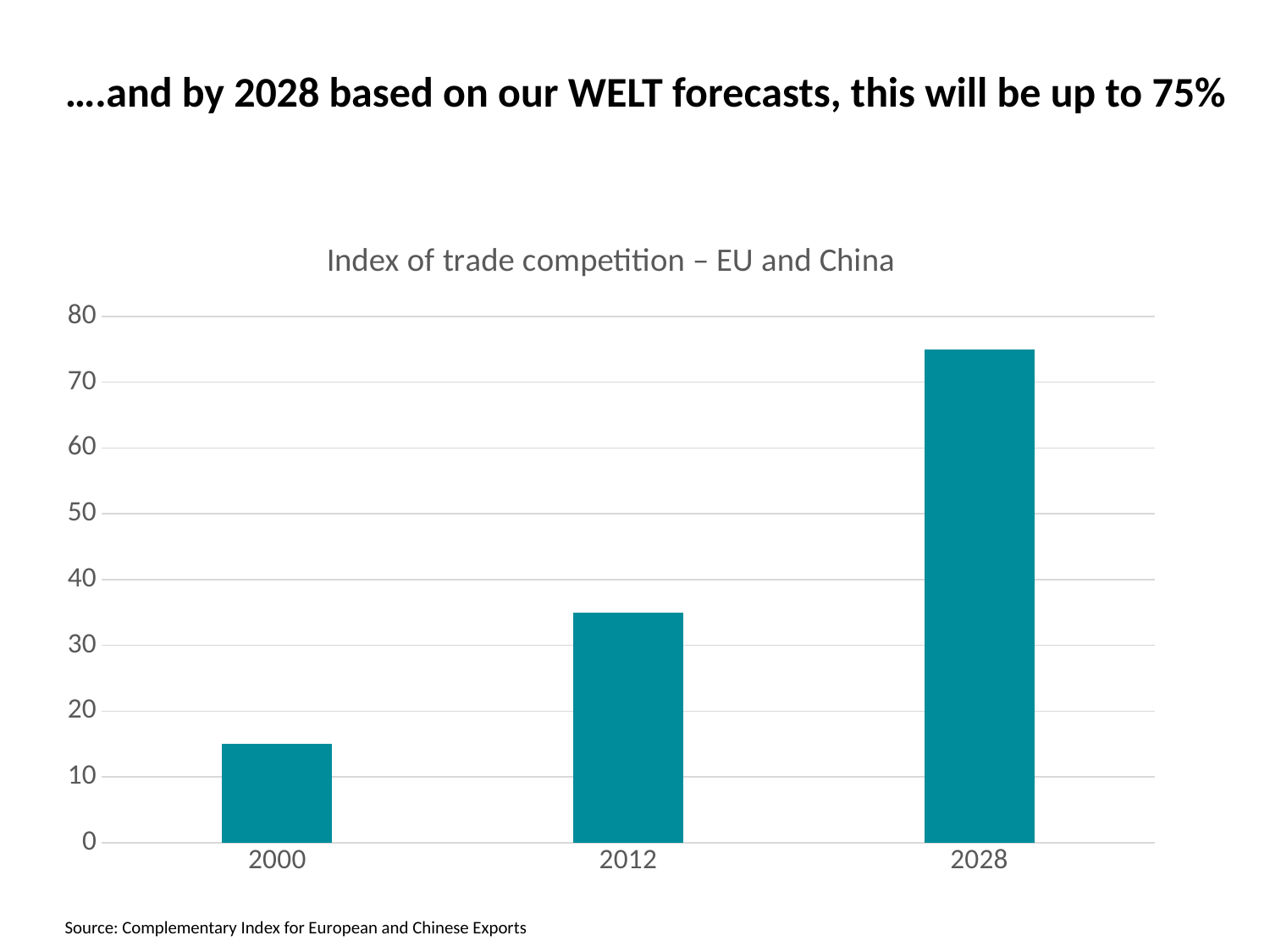
Is the value for 2012 greater or less than 30? greater What is the source cited below the chart? Complementary Index for European and Chinese Exports What kind of chart is shown on the slide? bar chart How many years are shown on the x axis of the chart? 3 Which year has the highest index value? 2028 Is the value for 2012 greater or less than 40? less Is the value for 2000 greater or less than 20? less Do the values rise or fall from 2000 to 2028? rise What is the title of the chart? Index of trade competition – EU and China Which is larger, the value for 2012 or the value for 2000? 2012 Which year has the lowest index value? 2000